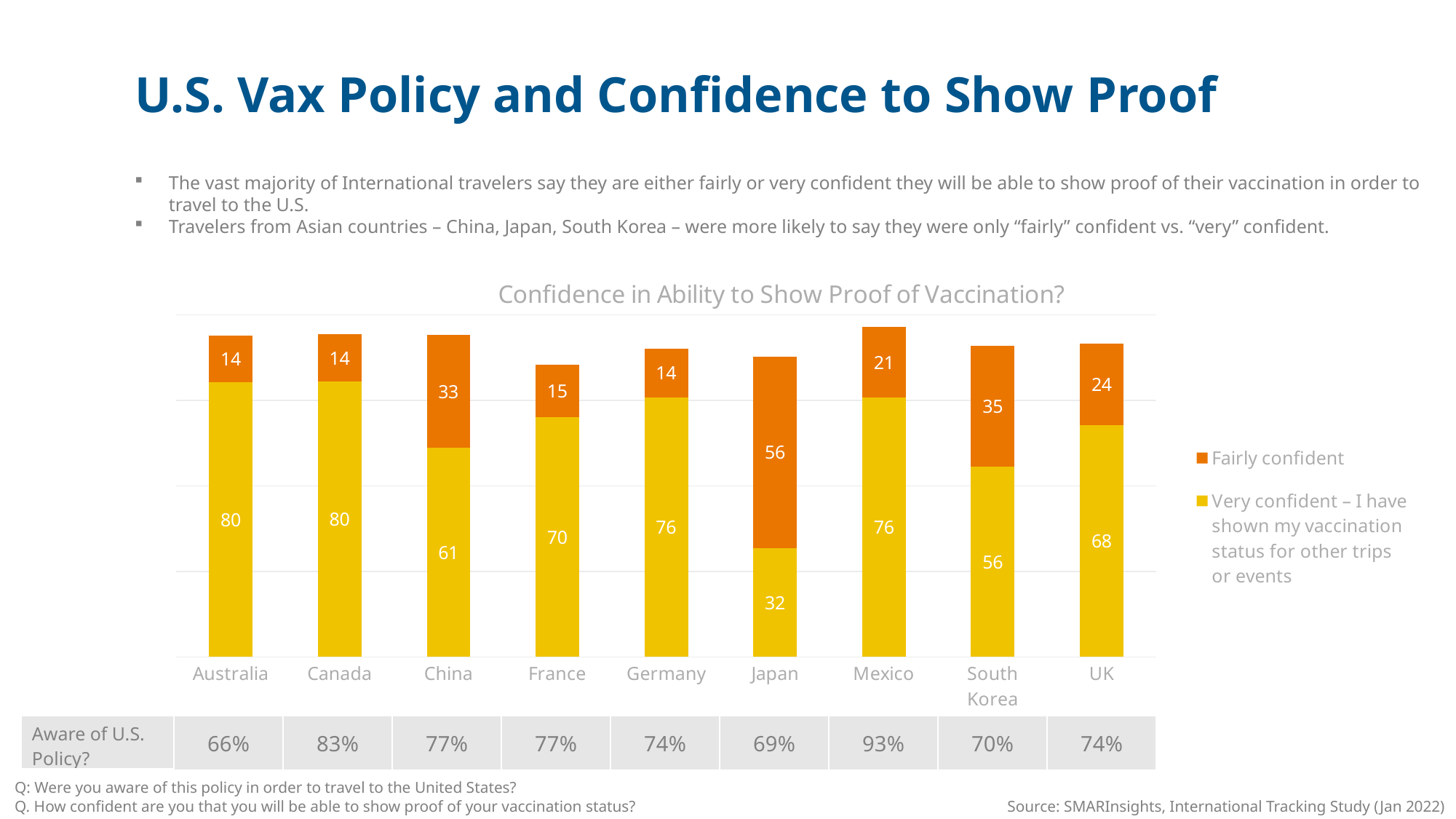
What is the 'Fairly confident' value for South Korea? 35 What is the difference between the 'Very confident' values for Germany and France? 6 Which country has the lowest 'Very confident' value? Japan Which has a larger 'Very confident' value, China or the UK? UK What is the 'Fairly confident' value for Mexico? 21 What kind of chart is shown on the slide? Stacked bar chart What is the title of the chart? Confidence in Ability to Show Proof of Vaccination? How many series does the chart's legend list? 2 What is the 'Very confident' value for Japan? 32 What is the total of the stacked bar for Mexico? 97 Which country has the highest 'Fairly confident' value? Japan How many countries are shown on the x axis of the chart? 9